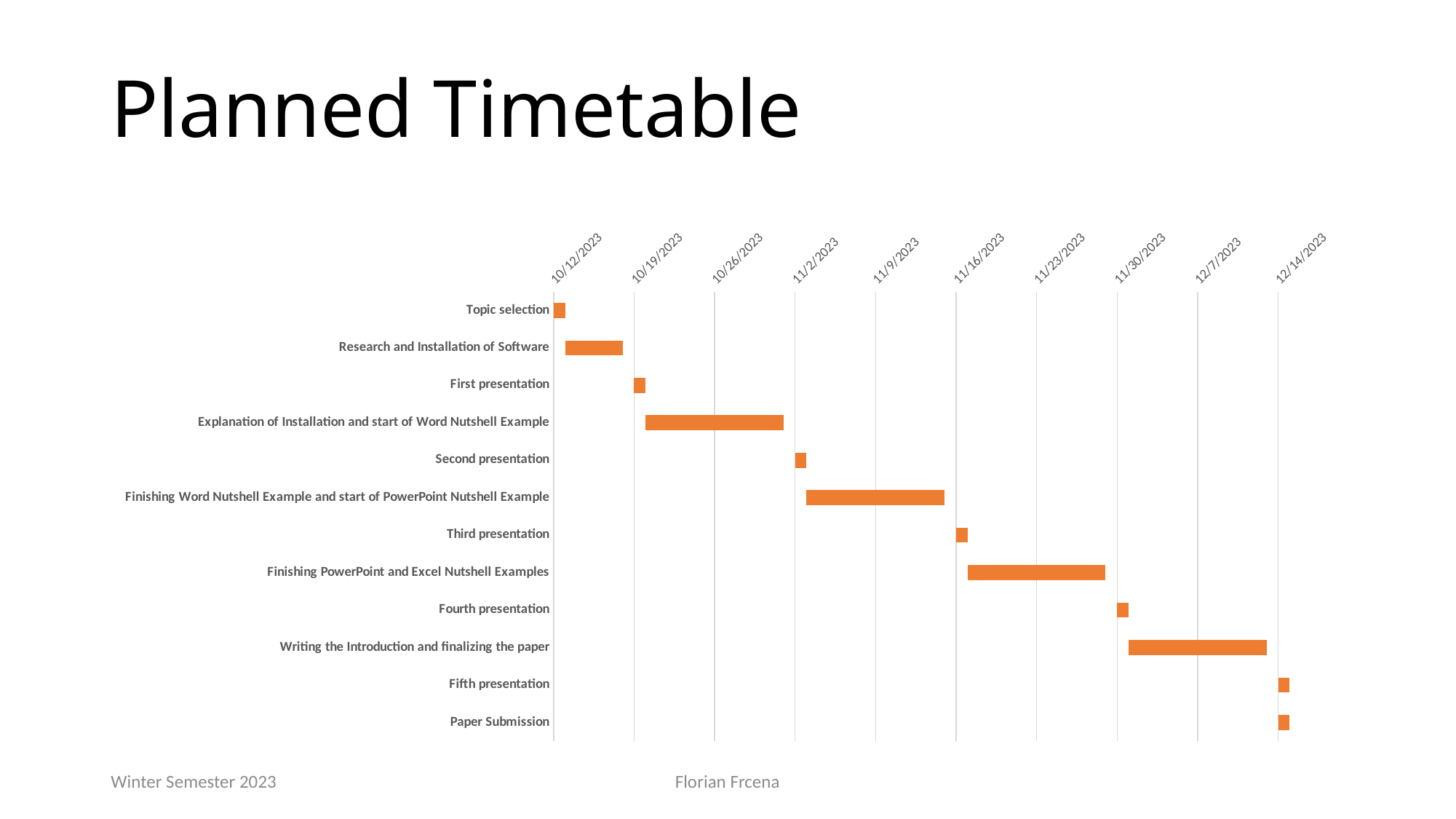
What is the title of the slide containing the chart? Planned Timetable Which task is listed first (at the top) of the chart? Topic selection How many tasks are listed on the vertical axis of the chart? 12 Does the bar for Topic selection start before or after 10/19/2023? before Do the task bars move to later dates or earlier dates as you go down the list of tasks? later dates Does the bar for Third presentation fall before or after 11/9/2023? after What is the first date shown on the chart's date axis? 10/12/2023 Which bar is longer: Explanation of Installation and start of Word Nutshell Example or Second presentation? Explanation of Installation and start of Word Nutshell Example Which bar is longer: Research and Installation of Software or Topic selection? Research and Installation of Software What kind of chart is shown on the slide? Bar chart (Gantt chart) Which task is listed last (at the bottom) of the chart? Paper Submission Does the bar for Paper Submission fall before or after 12/7/2023? after